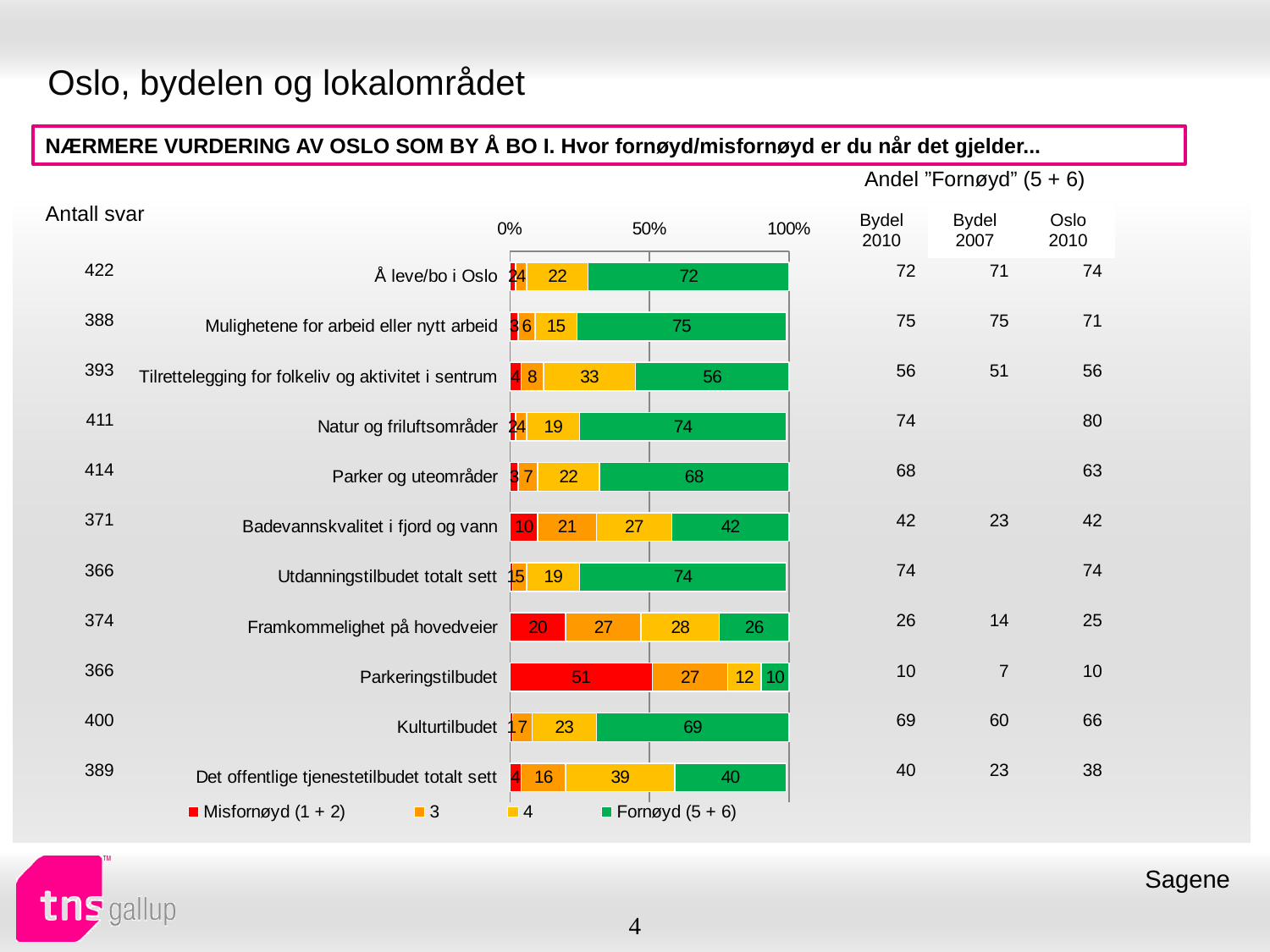
What is the Fornøyd (5 + 6) value for Parkeringstilbudet in the bar chart? 10 Which category has the highest Fornøyd (5 + 6) value in the bar chart? Mulighetene for arbeid eller nytt arbeid How many series does the legend of the bar chart list? 4 How many categories (rows) does the bar chart show? 11 What kind of chart is shown on the slide? bar chart Which category has the lowest Fornøyd (5 + 6) value in the bar chart? Parkeringstilbudet What is the Misfornøyd (1 + 2) value for Parkeringstilbudet in the bar chart? 51 Which legend entry is shown in green in the bar chart? Fornøyd (5 + 6) What is the Misfornøyd (1 + 2) value for Framkommelighet på hovedveier in the bar chart? 20 What is the difference between the Fornøyd (5 + 6) values for Å leve/bo i Oslo and Badevannskvalitet i fjord og vann? 30 What is the value of series 4 for Det offentlige tjenestetilbudet totalt sett in the bar chart? 39 Which has the larger Fornøyd (5 + 6) value: Framkommelighet på hovedveier or Det offentlige tjenestetilbudet totalt sett? Det offentlige tjenestetilbudet totalt sett